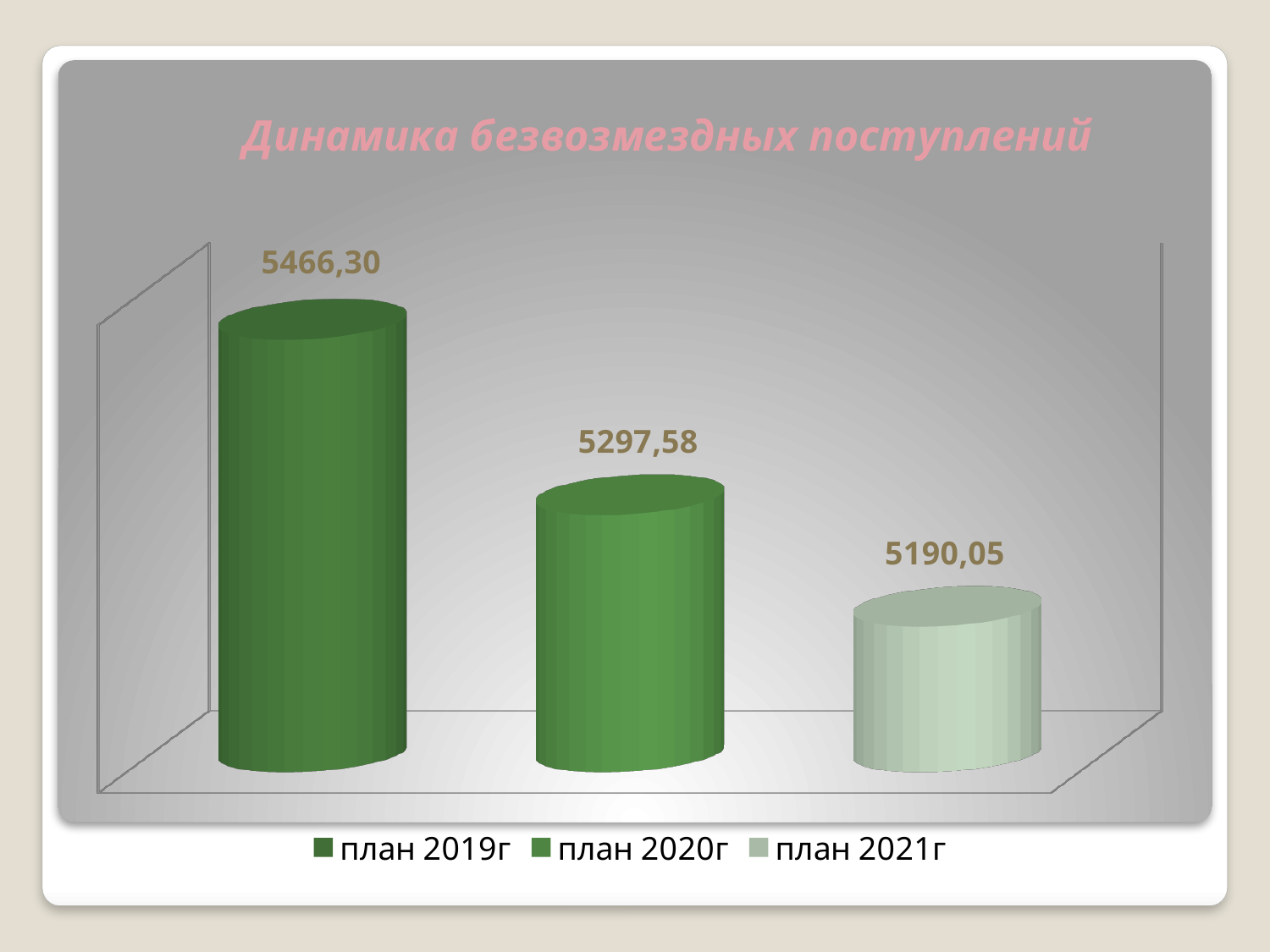
What is the value for план 2019г? 5466,30 How many series does the legend list? 3 What is the difference between the values for план 2020г and план 2021г? 107,53 Do the values rise or fall from план 2019г to план 2021г? fall Which series has the lowest value? план 2021г What is the value for план 2021г? 5190,05 Which series has the highest value? план 2019г What is the difference between the values for план 2019г and план 2021г? 276,25 What kind of chart is shown on the slide? bar chart What is the difference between the values for план 2019г and план 2020г? 168,72 What is the value for план 2020г? 5297,58 Which is larger, the value for план 2020г or the value for план 2021г? план 2020г